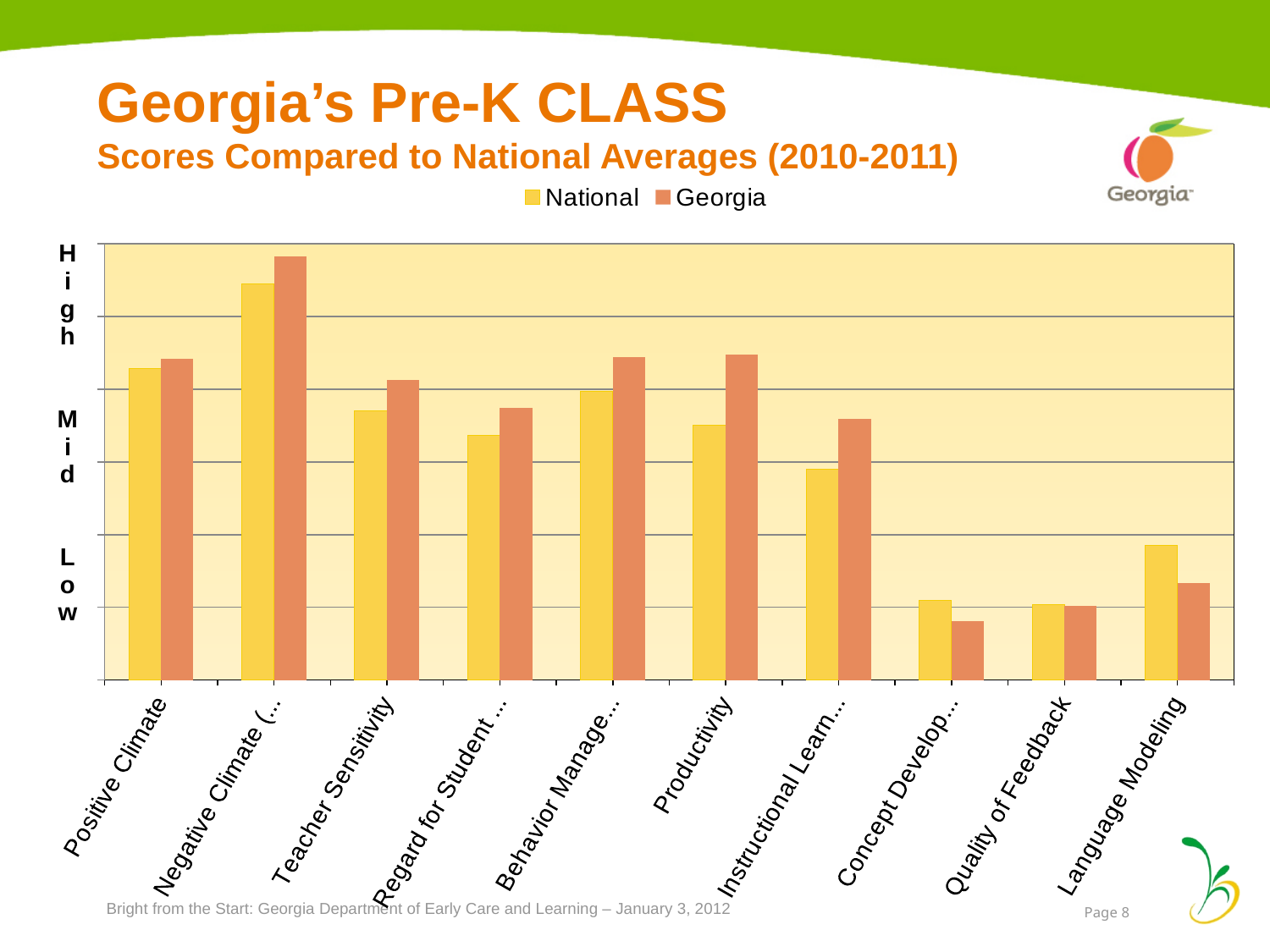
For Teacher Sensitivity, which is higher: the National score or the Georgia score? Georgia How many categories are plotted along the x axis? 10 What kind of chart is shown on the slide? bar chart Which category has the lowest Georgia score? Concept Development For Concept Development, which is higher: the National score or the Georgia score? National Which category has the highest National score? Negative Climate For Productivity, which is higher: the National score or the Georgia score? Georgia What are the two series named in the legend? National and Georgia How many series does the legend list? 2 Which category has the highest Georgia score? Negative Climate Which series is shown in yellow? National